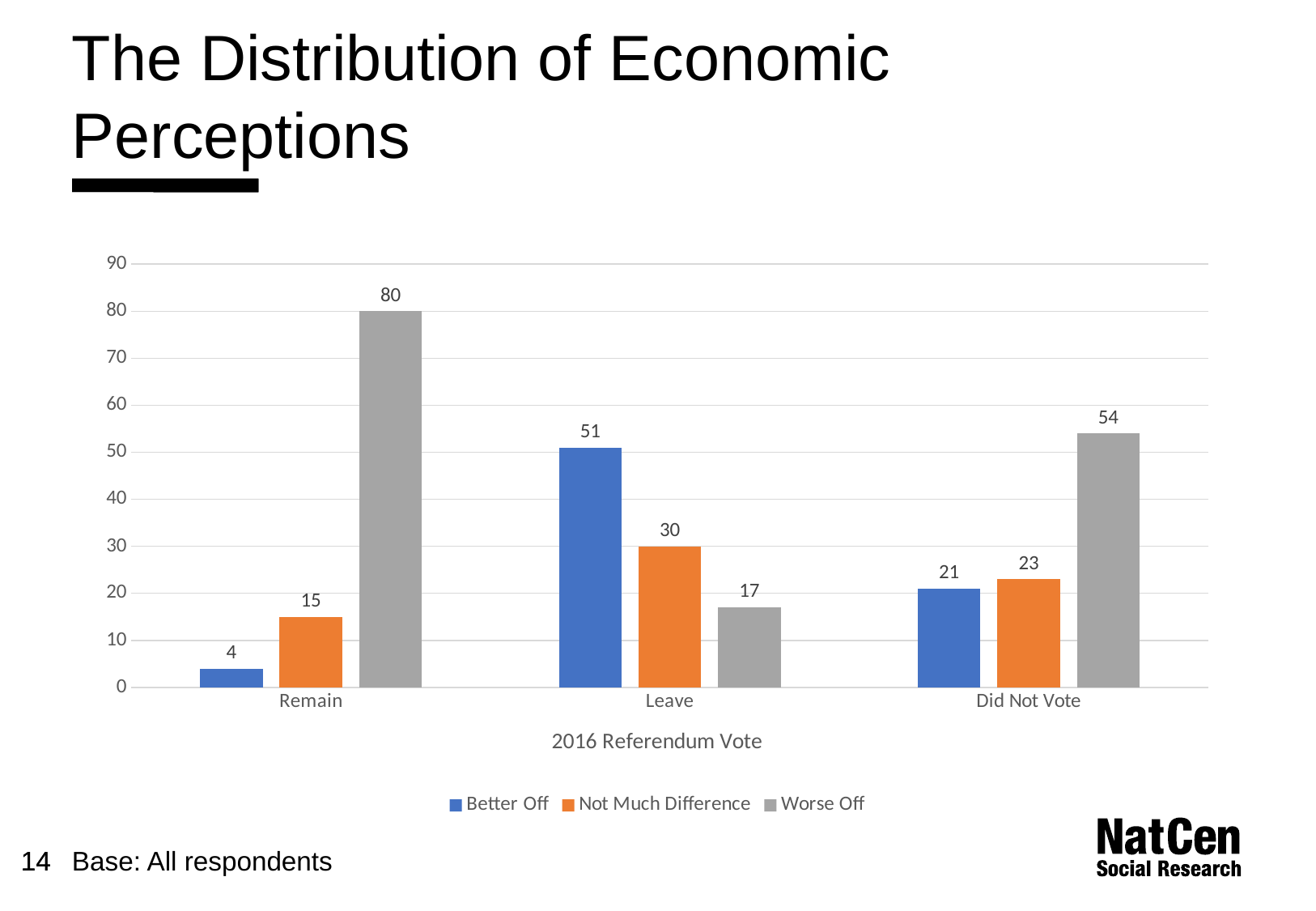
Which category has the highest Better Off value? Leave What is the value for Not Much Difference among those who Did Not Vote? 23 What is the difference between the Worse Off values for Remain and Did Not Vote? 26 What is the value for Better Off among Leave voters? 51 Which is larger for Leave voters: Not Much Difference or Worse Off? Not Much Difference Which colour represents the Worse Off series? Grey What is the value for Worse Off among Remain voters? 80 What kind of chart is shown on the slide? Bar chart How many series does the legend list? 3 How many categories are shown on the x axis? 3 Which category has the lowest Worse Off value? Leave What is the x-axis title of the chart? 2016 Referendum Vote